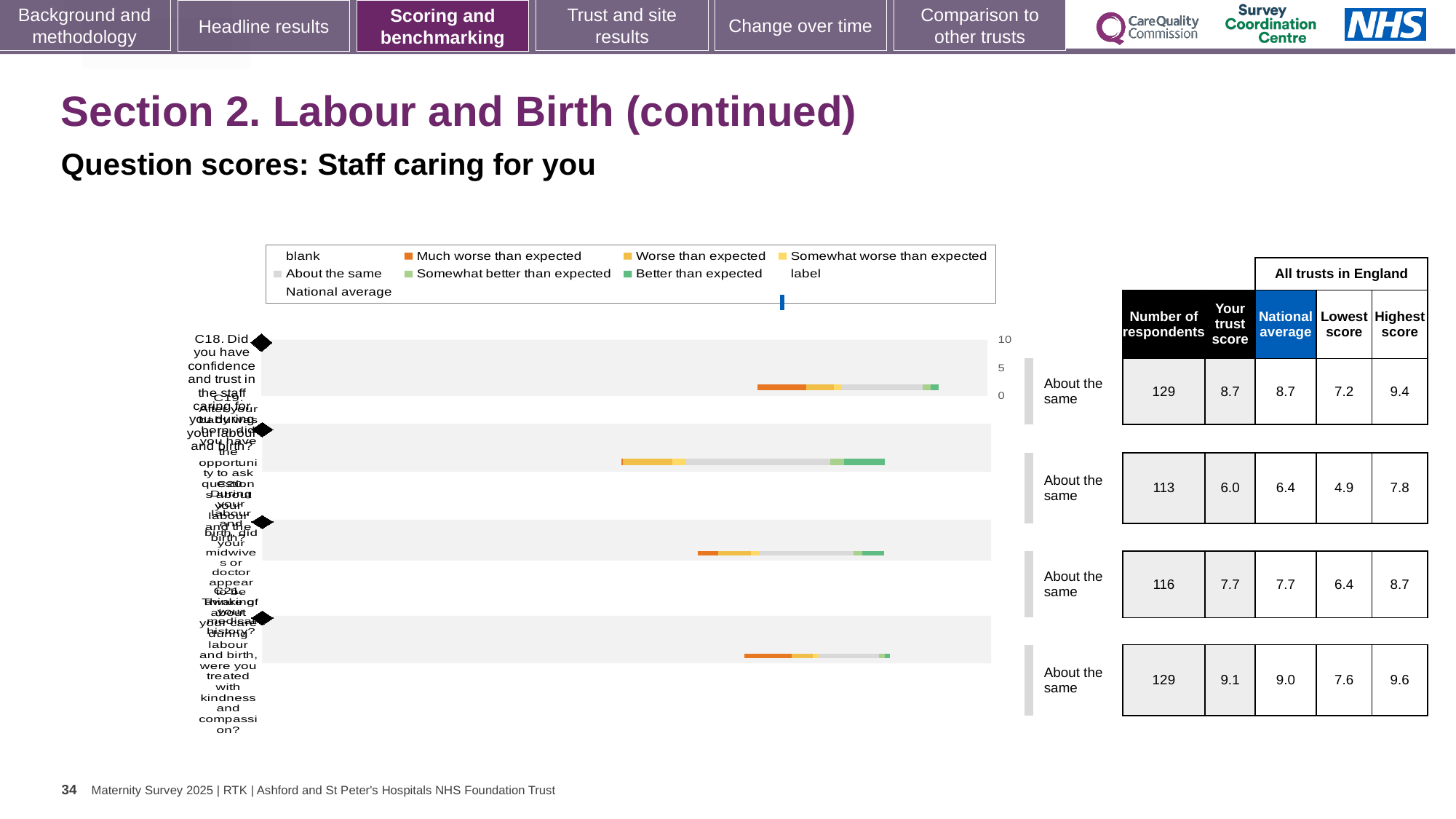
Which question row has the highest trust score? C21 (the last row), 9.1 What is the highest score among all trusts in England for the last question, C21? 9.6 What is the number of respondents for the first (top) question, C18? 129 What is the national average for the second question row? 6.4 What is the trust score for the last question, C21 (treated with kindness and compassion)? 9.1 Which question row has the lowest trust score? the second row, 6.0 What benchmark category is shown for every question row on the slide? About the same What kind of chart is shown on the slide? bar chart How many questions (rows) are plotted in the chart? 4 What is the difference between the highest score and the lowest score for the first question, C18? 2.2 What is the lowest score among all trusts in England for the third question row? 6.4 Which is larger: the trust score for the first row (C18) or the trust score for the second row? the first row (C18)